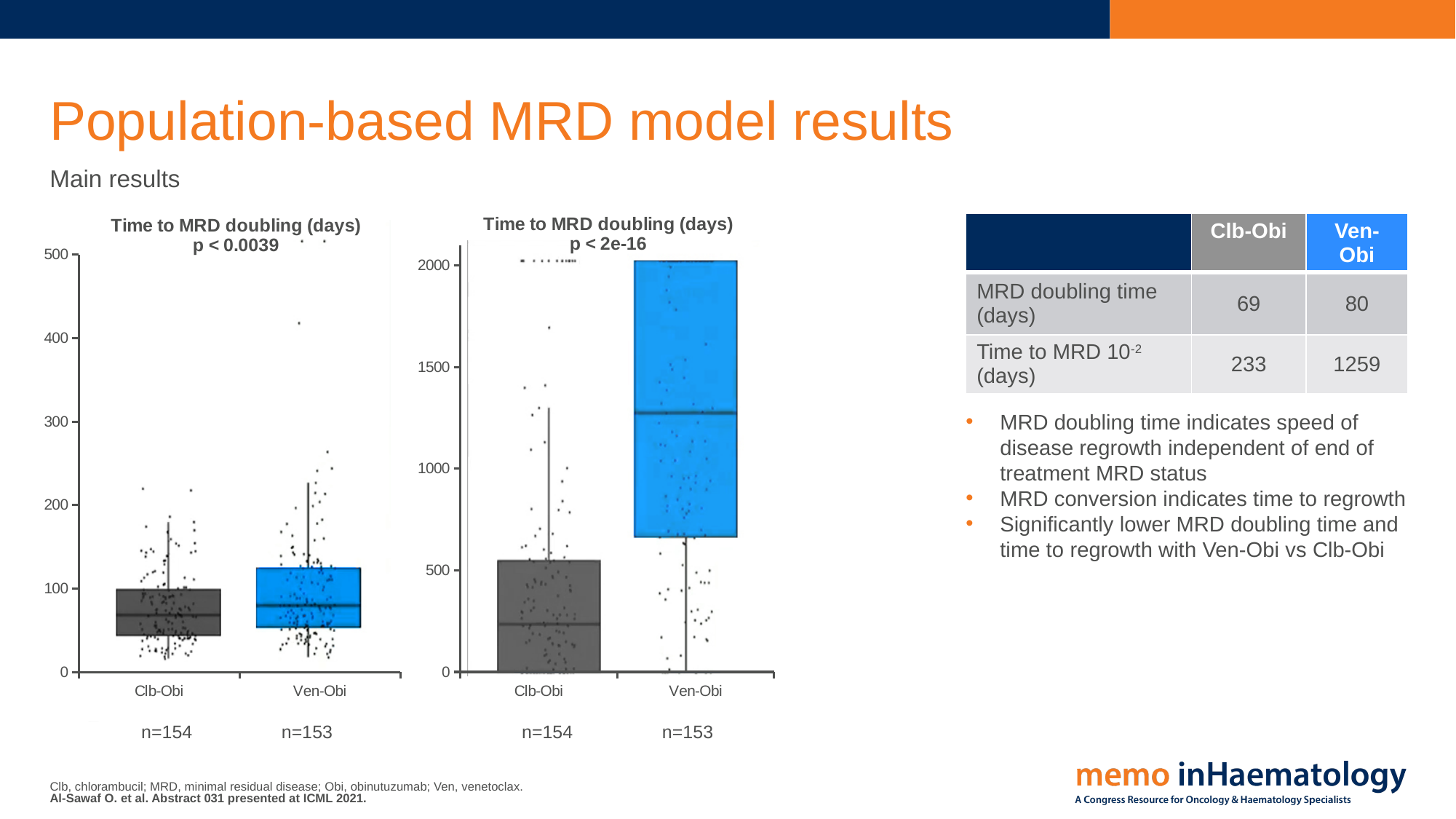
What kind of chart is the left chart titled 'Time to MRD doubling (days) p < 0.0039'? box plot In the right chart (p < 2e-16), which group has the higher median time to MRD doubling? Ven-Obi In the right chart (p < 2e-16), is the median for Ven-Obi greater or less than 1000? greater What p-value is shown in the title of the right chart? p < 2e-16 In the left chart (p < 0.0039), which group has the higher median time to MRD doubling? Ven-Obi How many treatment groups are shown on the x axis of the right chart (p < 2e-16)? 2 According to the table on the slide, what is the difference in time to MRD 10^-2 (days) between Ven-Obi (1259) and Clb-Obi (233)? 1026 In the left chart (p < 0.0039), is the median for Ven-Obi greater or less than 100? less What p-value is shown in the title of the left chart? p < 0.0039 In the left chart (p < 0.0039), is the median for Clb-Obi greater or less than 100? less What is the sample size (n) shown for the Clb-Obi group under the charts? n=154